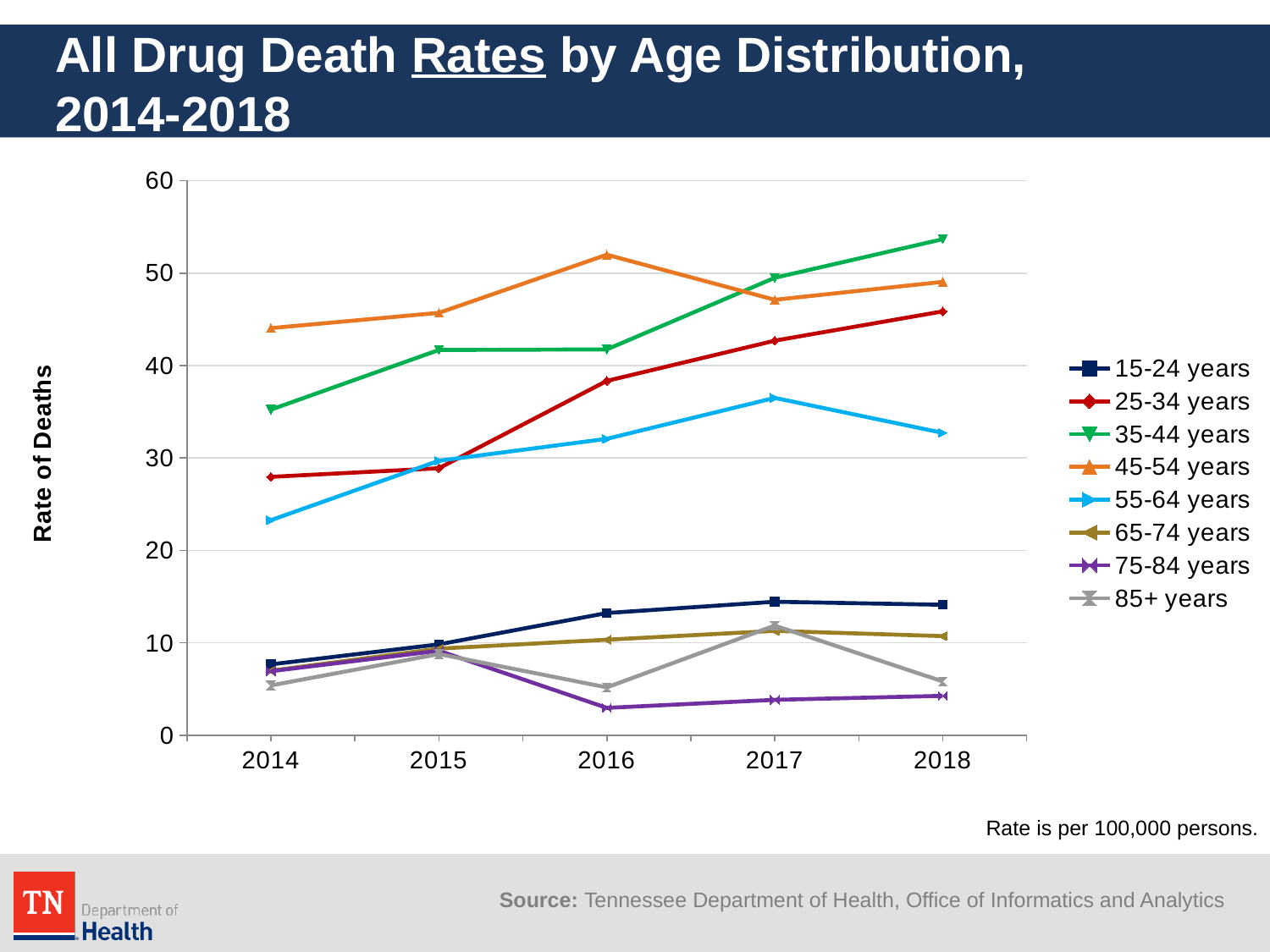
Which age group has the highest drug death rate in 2018? 35-44 years Which age group has the highest drug death rate in 2014? 45-54 years Which age group has the lowest drug death rate in 2018? 75-84 years Is the rate for the 35-44 years group in 2014 greater or less than 40? less Is the rate for the 45-54 years group in 2016 greater or less than 50? greater Does the rate for the 25-34 years group rise or fall from 2014 to 2018? Rises According to the note on the slide, the rate is per how many persons? 100,000 persons How many years are plotted along the x axis? 5 In 2018, which has the higher rate: the 25-34 years group or the 55-64 years group? 25-34 years What kind of chart is shown on the slide? Line chart What is the title of the y axis? Rate of Deaths How many age groups does the legend list? 8